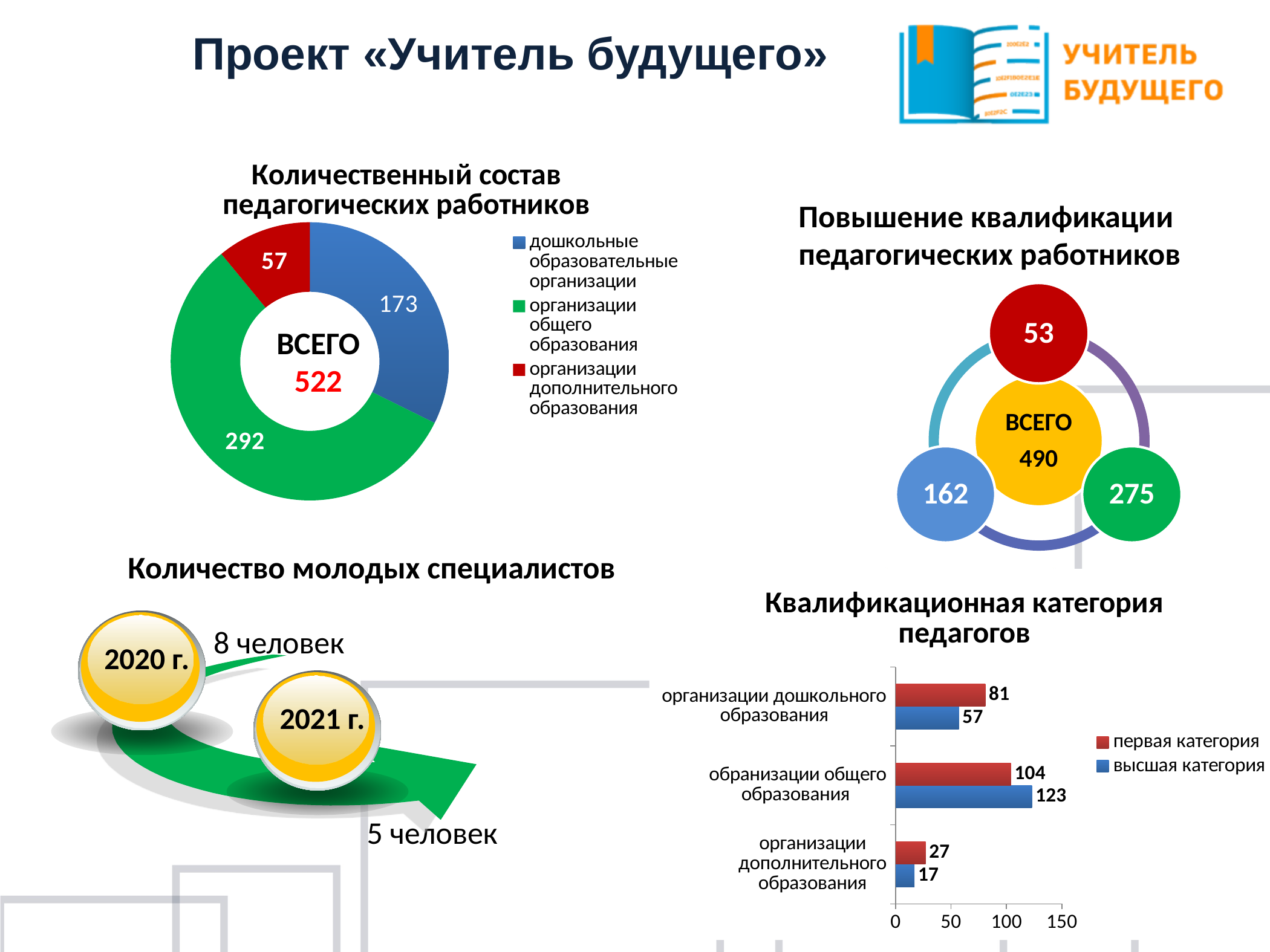
In the chart 'Квалификационная категория педагогов', what is the value of 'высшая категория' for 'обранизации общего образования'? 123 In the chart 'Количественный состав педагогических работников', what is the difference between the values for 'организации общего образования' and 'дошкольные образовательные организации'? 119 In the chart 'Количественный состав педагогических работников', what is the value for 'организации общего образования'? 292 In the chart 'Квалификационная категория педагогов', what is the value of 'первая категория' for 'организации дошкольного образования'? 81 How many series does the legend of the chart 'Квалификационная категория педагогов' list? 2 In the chart 'Квалификационная категория педагогов', what is the difference between 'первая категория' and 'высшая категория' for 'организации дошкольного образования'? 24 In the chart 'Количественный состав педагогических работников', which category has the smallest value? организации дополнительного образования In the chart 'Квалификационная категория педагогов', which is larger for 'организации дополнительного образования': 'первая категория' or 'высшая категория'? первая категория In the chart 'Количественный состав педагогических работников', what is the value for 'дошкольные образовательные организации'? 173 What kind of chart is 'Квалификационная категория педагогов'? bar chart What kind of chart is 'Количественный состав педагогических работников'? doughnut chart In the chart 'Количественный состав педагогических работников', what is the total shown in the centre? 522